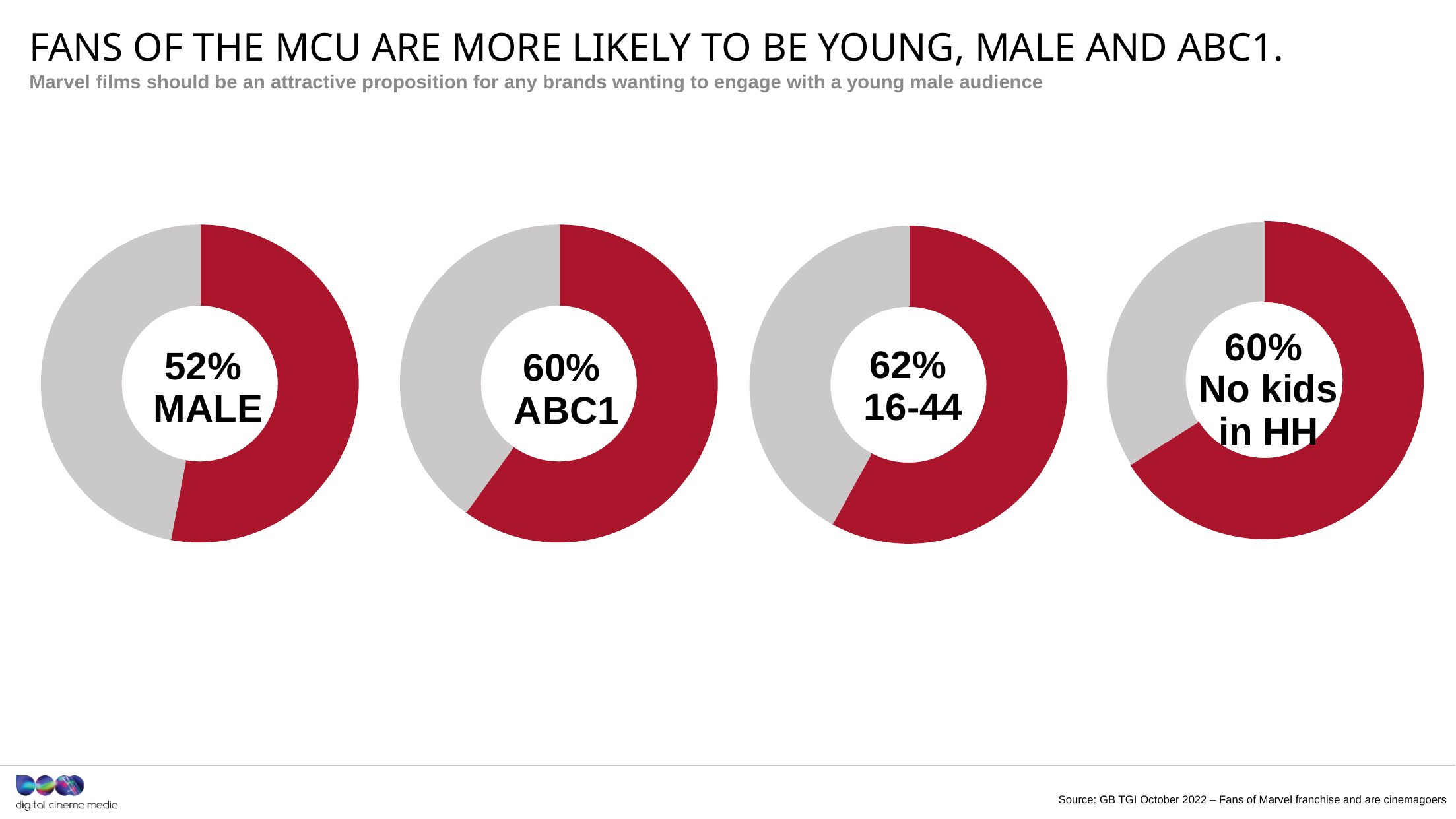
What is the difference between the percentage in the 16-44 donut chart and the percentage in the MALE donut chart? 10% What percentage is shown in the first (leftmost) donut chart, labelled MALE? 52% What colour is used for the highlighted (percentage) portion of each donut chart? Red How many donut charts are shown on the slide? 4 What percentage is shown in the second donut chart, labelled ABC1? 60% Which of the four donut charts shows the highest percentage? 16-44 What percentage is shown in the third donut chart, labelled 16-44? 62% Which is larger: the percentage in the ABC1 donut chart or the percentage in the MALE donut chart? ABC1 What percentage is shown in the fourth (rightmost) donut chart, labelled No kids in HH? 60% In the MALE donut chart, what share of the ring is shaded red? 52% What kind of chart is used to show the MALE percentage? Donut (pie) chart Which of the four donut charts shows the lowest percentage? MALE